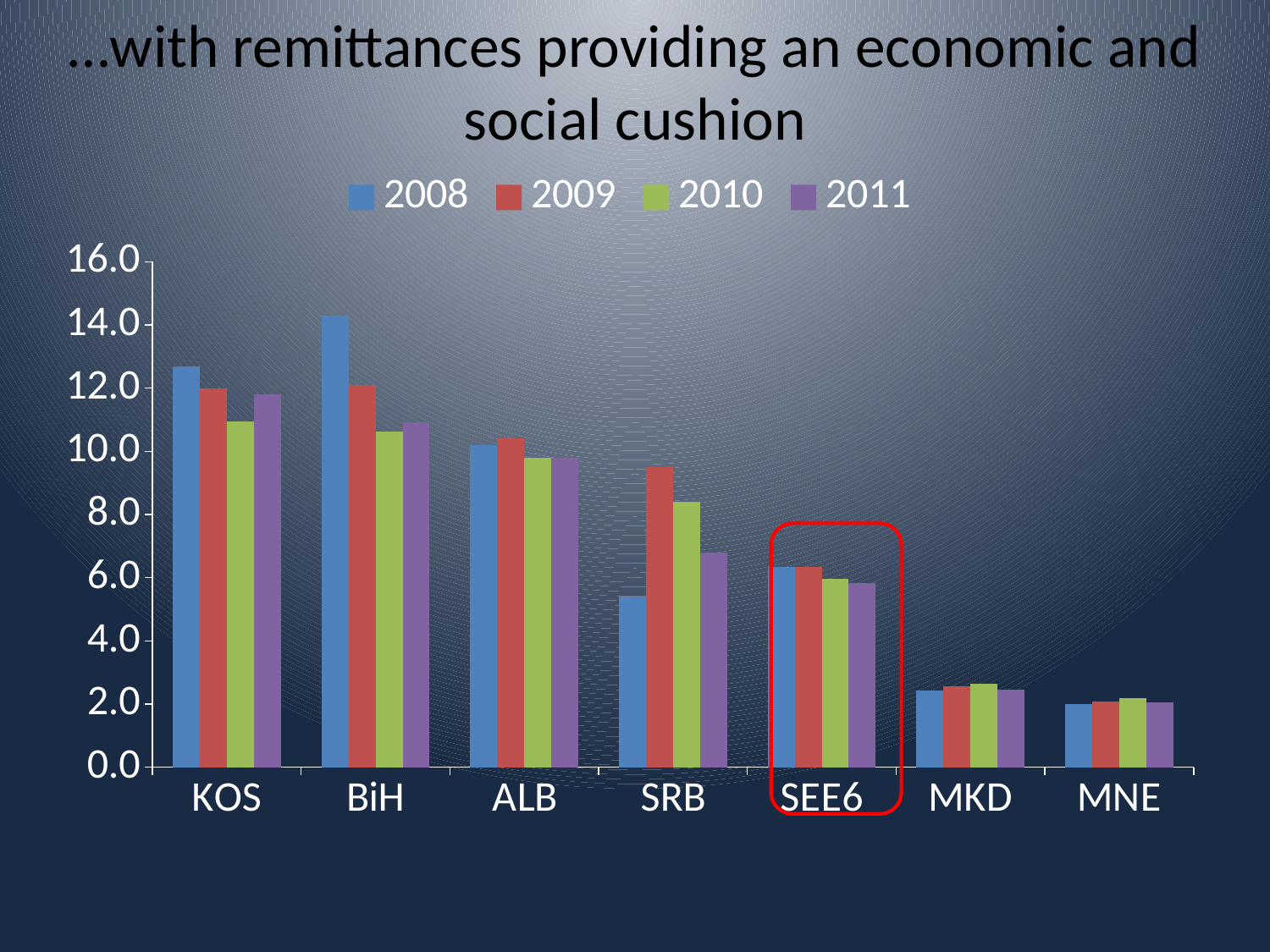
Which is larger: the 2010 value for KOS or the 2010 value for ALB? KOS Which category is highlighted with a red box? SEE6 Which category has the highest 2008 bar? BiH Is the 2008 value for KOS greater or less than 12.0? greater How many series does the legend list? 4 Moving from BiH to MNE along the x axis, do the 2010 bars rise or fall? fall Is the 2011 value for MKD greater or less than 4.0? less Which category has the lowest 2008 bar? MNE Is the 2008 value for SRB greater or less than 6.0? less How many categories are shown on the x axis? 7 For SRB, which is larger: the 2008 value or the 2009 value? 2009 What kind of chart is shown on the slide? bar chart